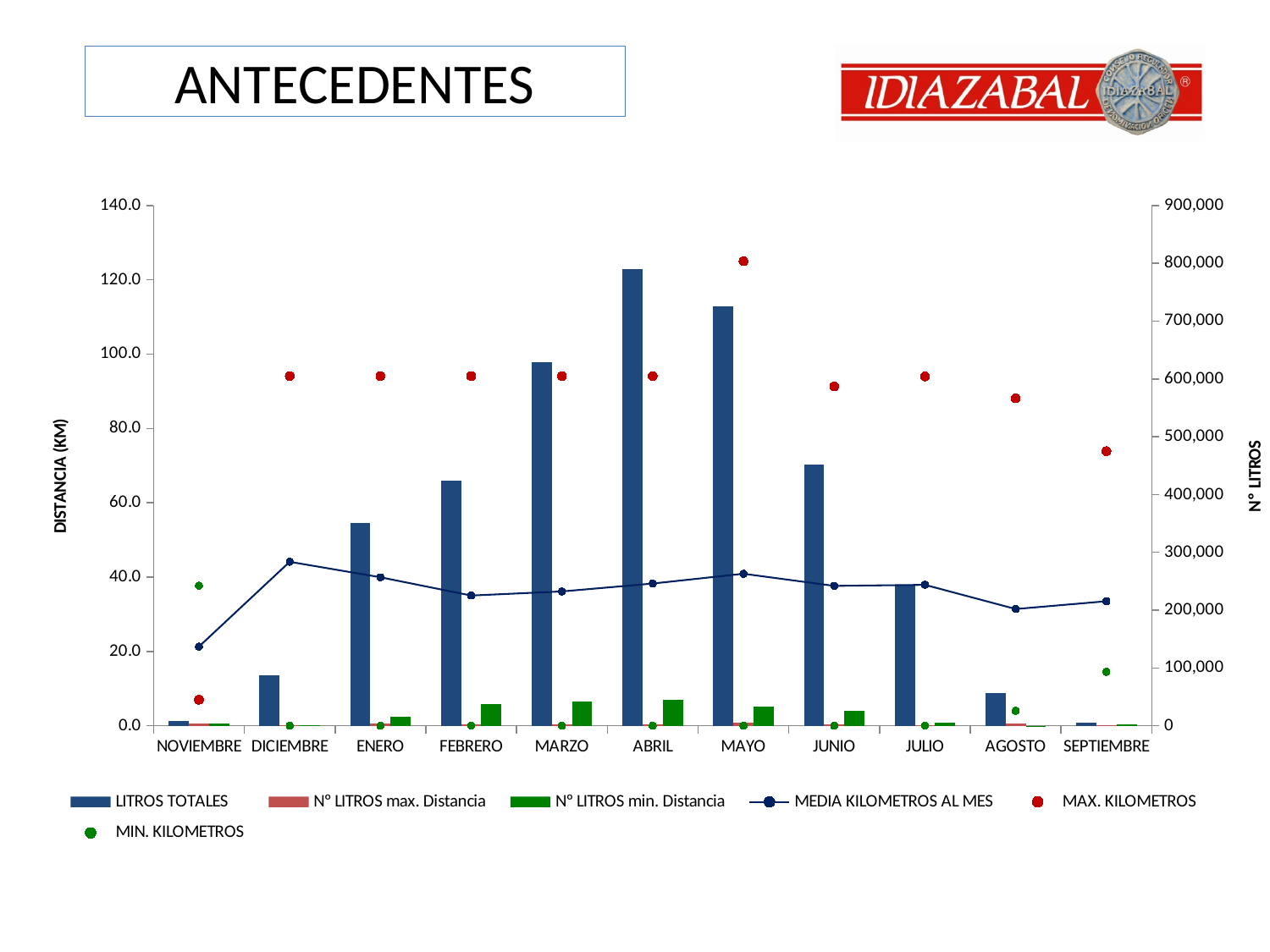
What kind of chart is shown on the slide? Combined bar and line chart Which month has a larger LITROS TOTALES bar, ABRIL or MAYO? ABRIL How many months are shown on the x axis of the chart? 11 Is the MEDIA KILOMETROS AL MES value for DICIEMBRE greater or less than 40.0 on the left axis? greater In which month is the MEDIA KILOMETROS AL MES line at its lowest? NOVIEMBRE In which month is the LITROS TOTALES bar the highest? ABRIL Do the LITROS TOTALES bars rise or fall from NOVIEMBRE to ABRIL? rise Which month has a larger LITROS TOTALES bar, ENERO or FEBRERO? FEBRERO What is the title of the left vertical axis of the chart? DISTANCIA (KM) In which month is the MAX. KILOMETROS point the highest? MAYO Is the MEDIA KILOMETROS AL MES value for AGOSTO greater or less than 40.0 on the left axis? less How many series does the chart's legend list? 6